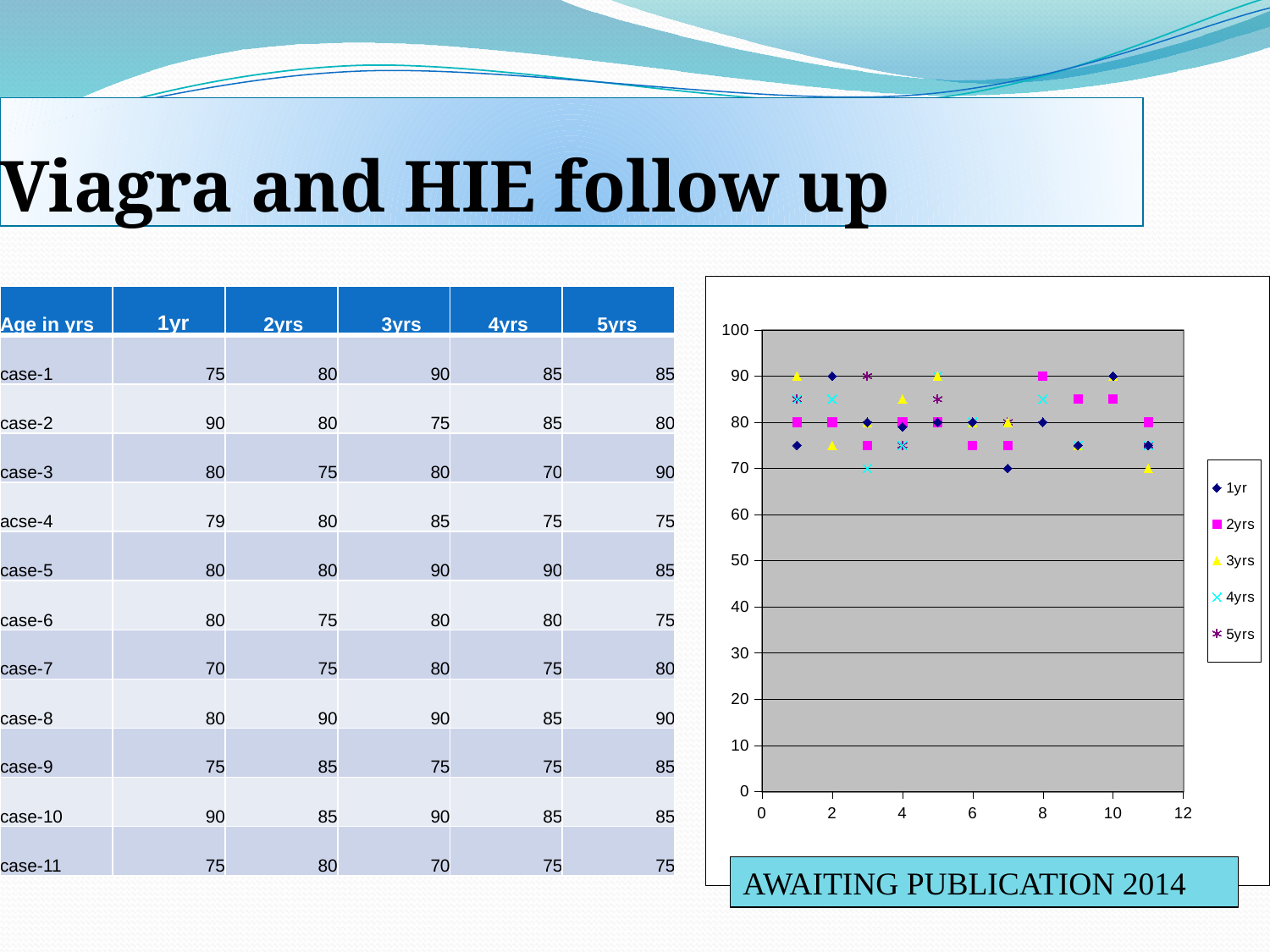
How many series does the chart's legend list? 5 What is the 1yr value at x = 7 in the chart? 70 What kind of chart is shown on the right of the slide? scatter chart At x = 3 in the chart, which series has the highest value? 5yrs At x = 3 in the chart, which series has the lowest value? 4yrs How many data points does each series in the chart have? 11 What is the 3yrs value at x = 11 in the chart? 70 What are the series names listed in the chart's legend? 1yr, 2yrs, 3yrs, 4yrs, 5yrs In the chart, is the 4yrs value at x = 3 greater or less than 80? less In the chart, is the 2yrs value at x = 8 greater or less than 80? greater In the chart, is the 1yr value at x = 7 greater or less than 80? less At x = 3 in the chart, what is the difference between the 5yrs value and the 4yrs value? 20